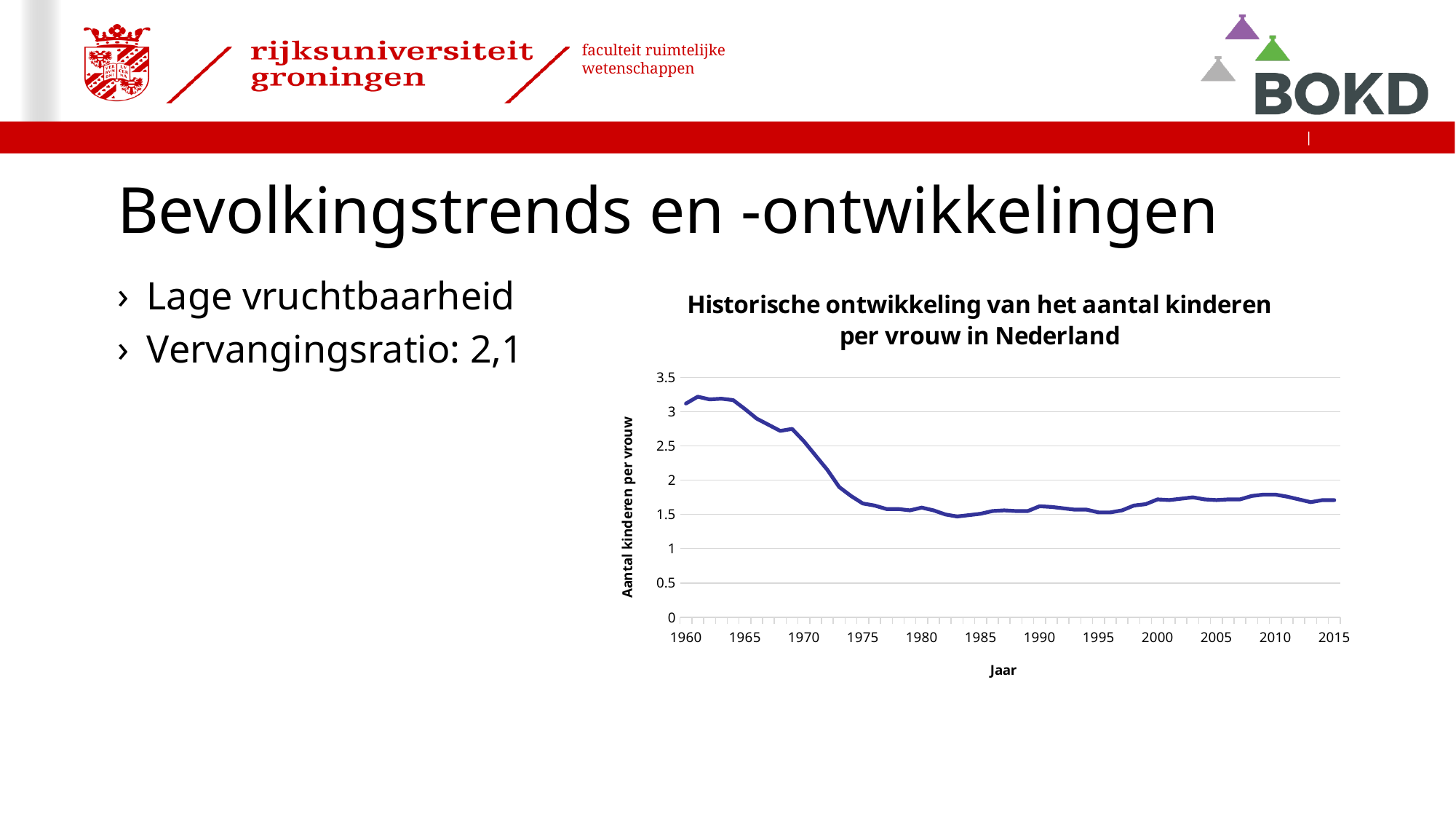
Is the value for 1965 greater or less than 2.5? greater What is the title of the chart? Historische ontwikkeling van het aantal kinderen per vrouw in Nederland Which year has the higher value, 1970 or 1990? 1970 What is the label of the x axis of the chart? Jaar What kind of chart is shown on the slide? line chart Is the value for 1970 greater or less than 3? less Is the value for 2010 greater or less than 1? greater Which year has the higher value, 1960 or 2015? 1960 Do the values rise or fall between 1960 and 1975? fall